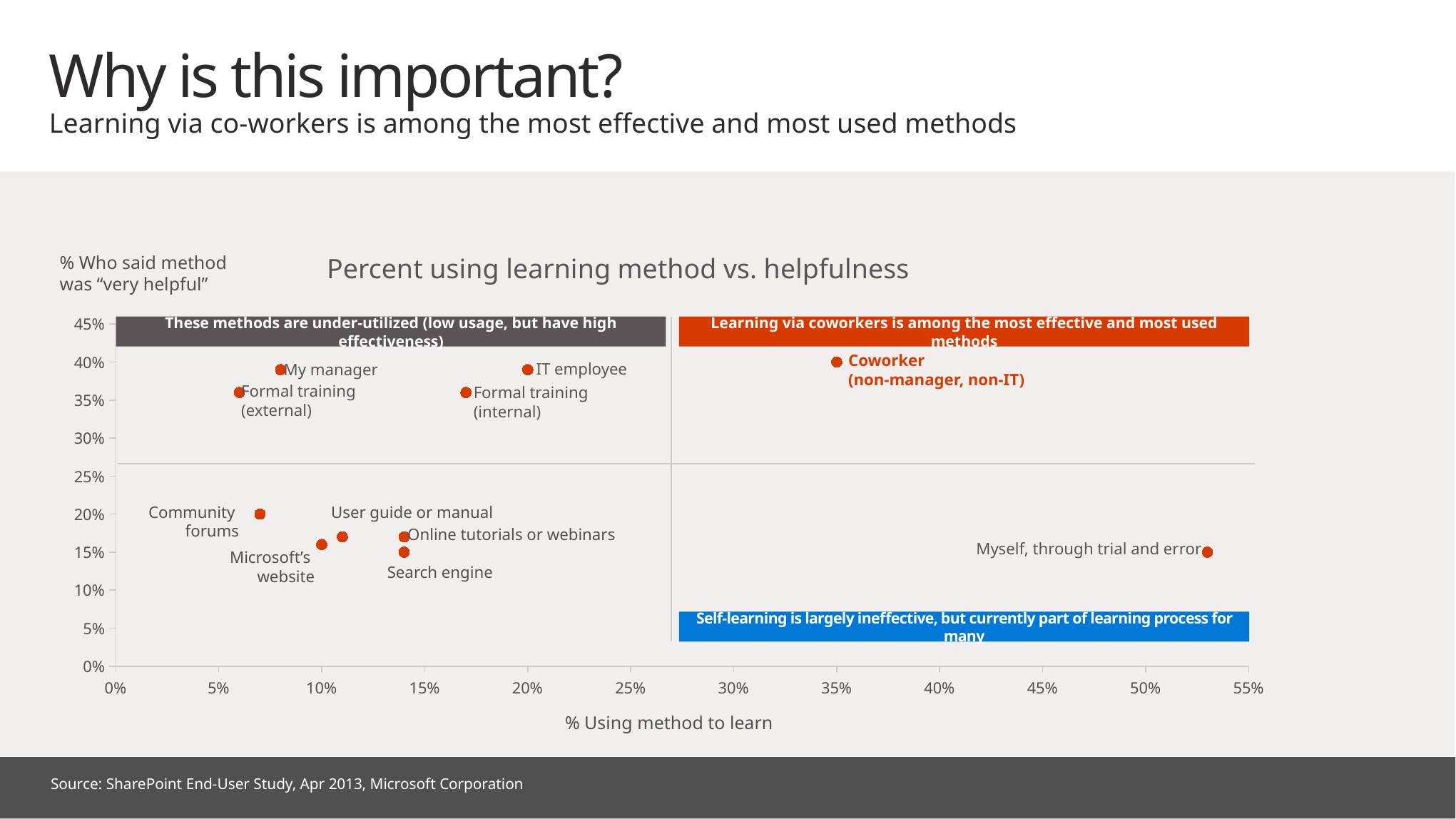
What is the label of the horizontal axis of the chart? % Using method to learn Which was rated very helpful by a larger percentage: "Coworker (non-manager, non-IT)" or "Myself, through trial and error"? Coworker (non-manager, non-IT) What is the title of the chart? Percent using learning method vs. helpfulness Is the percentage using "Myself, through trial and error" greater or less than 50%? greater What kind of chart is shown on the slide? Scatter chart How many learning methods are plotted as points on the chart? 11 Is the percentage who said "Search engine" was very helpful greater or less than 20%? less Which learning method has the highest percentage of people using it to learn? Myself, through trial and error Which has a higher percentage of people using it to learn: "IT employee" or "My manager"? IT employee Is the percentage using "Coworker (non-manager, non-IT)" greater or less than 30%? greater